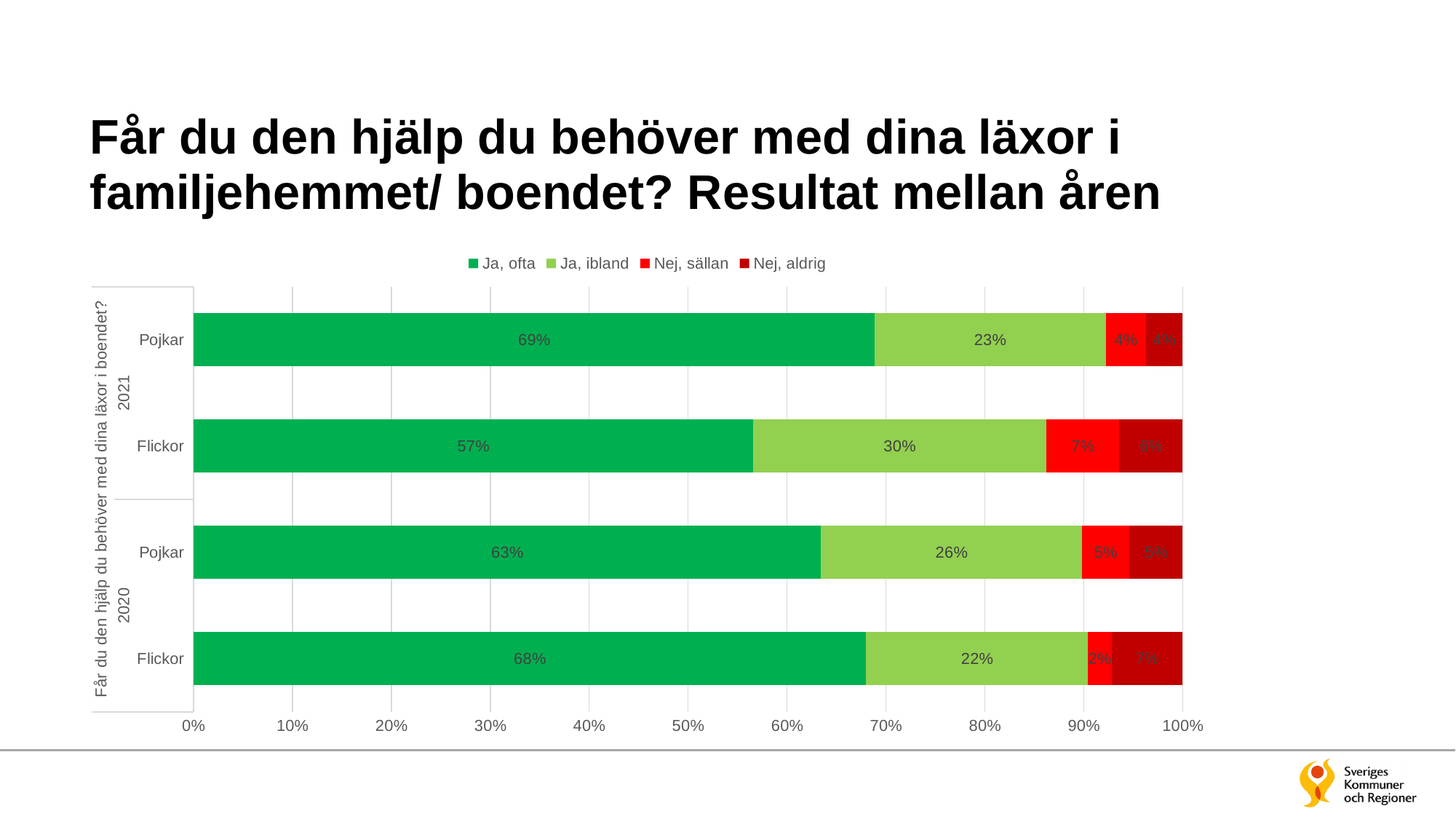
Which group and year has the lowest 'Ja, ofta' value? Flickor 2021 How many series does the legend list? 4 How many bars are plotted in the chart? 4 Which group and year has the highest 'Ja, ofta' value? Pojkar 2021 What is the 'Ja, ofta' value for Pojkar in 2021? 69% What kind of chart is shown on the slide? Stacked bar chart Which is larger: the 'Ja, ibland' value for Flickor in 2021 or for Flickor in 2020? Flickor 2021 What is the 'Nej, aldrig' value for Flickor in 2020? 7% What is the combined share of 'Nej, sällan' and 'Nej, aldrig' for Flickor in 2021? 13% What is the difference between the 'Ja, ofta' values for Pojkar in 2021 and Pojkar in 2020? 6 percentage points What is the 'Ja, ibland' value for Flickor in 2021? 30% What is the 'Nej, sällan' value for Pojkar in 2020? 5%